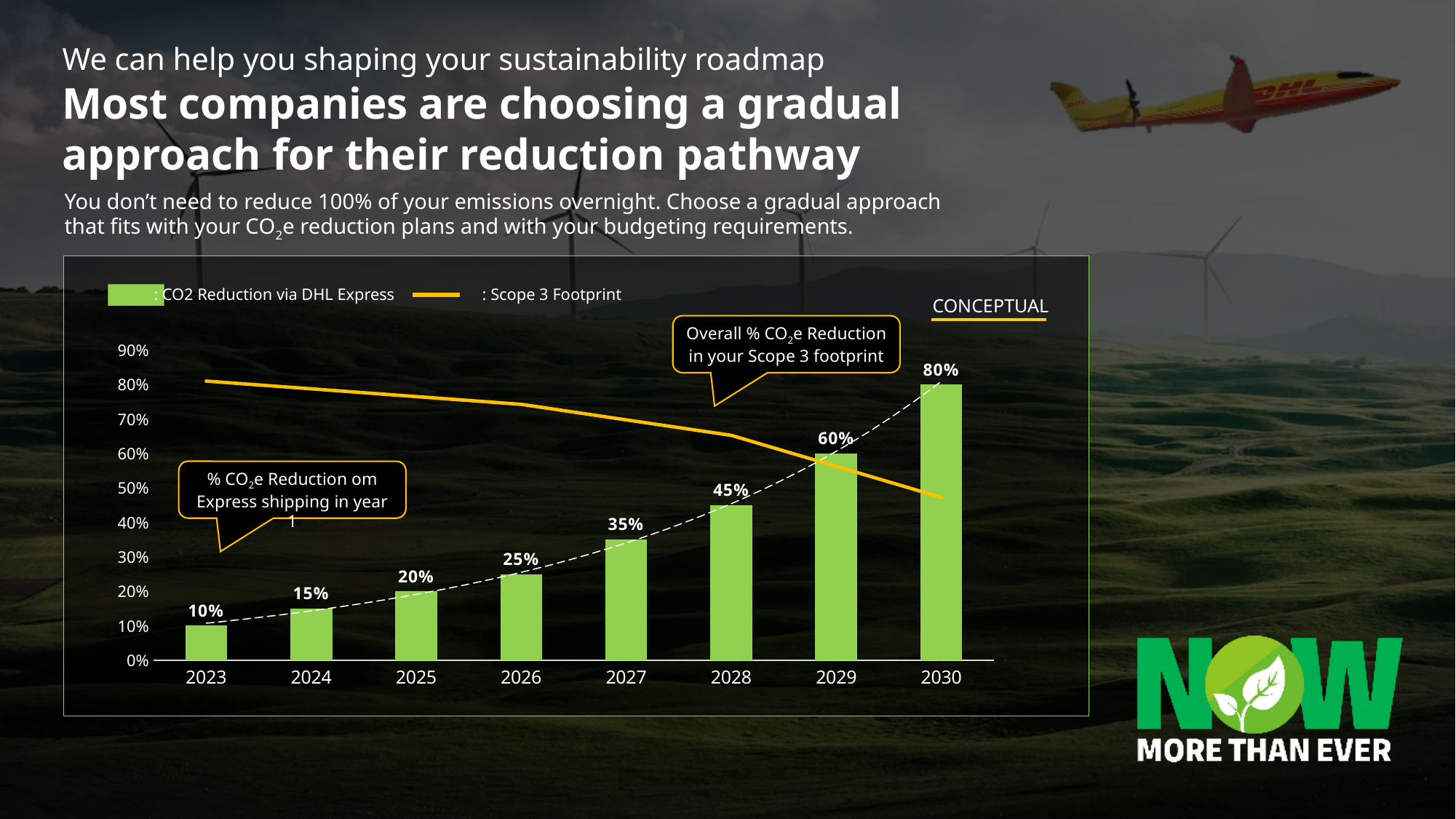
Which year has the highest CO2 Reduction via DHL Express bar? 2030 Is the Scope 3 Footprint value for 2023 greater or less than 70%? greater How many years are shown on the x axis of the chart? 8 Is the Scope 3 Footprint value for 2030 greater or less than 60%? less Which year has the lowest CO2 Reduction via DHL Express bar? 2023 What is the CO2 Reduction via DHL Express value for 2029? 60% What is the difference between the CO2 Reduction via DHL Express values for 2030 and 2027? 45% Does the Scope 3 Footprint line rise or fall from 2023 to 2030? fall Which is larger, the CO2 Reduction via DHL Express value for 2028 or for 2025? 2028 How many series does the chart legend list? 2 What is the CO2 Reduction via DHL Express value for 2026? 25% What is the CO2 Reduction via DHL Express value for 2023? 10%